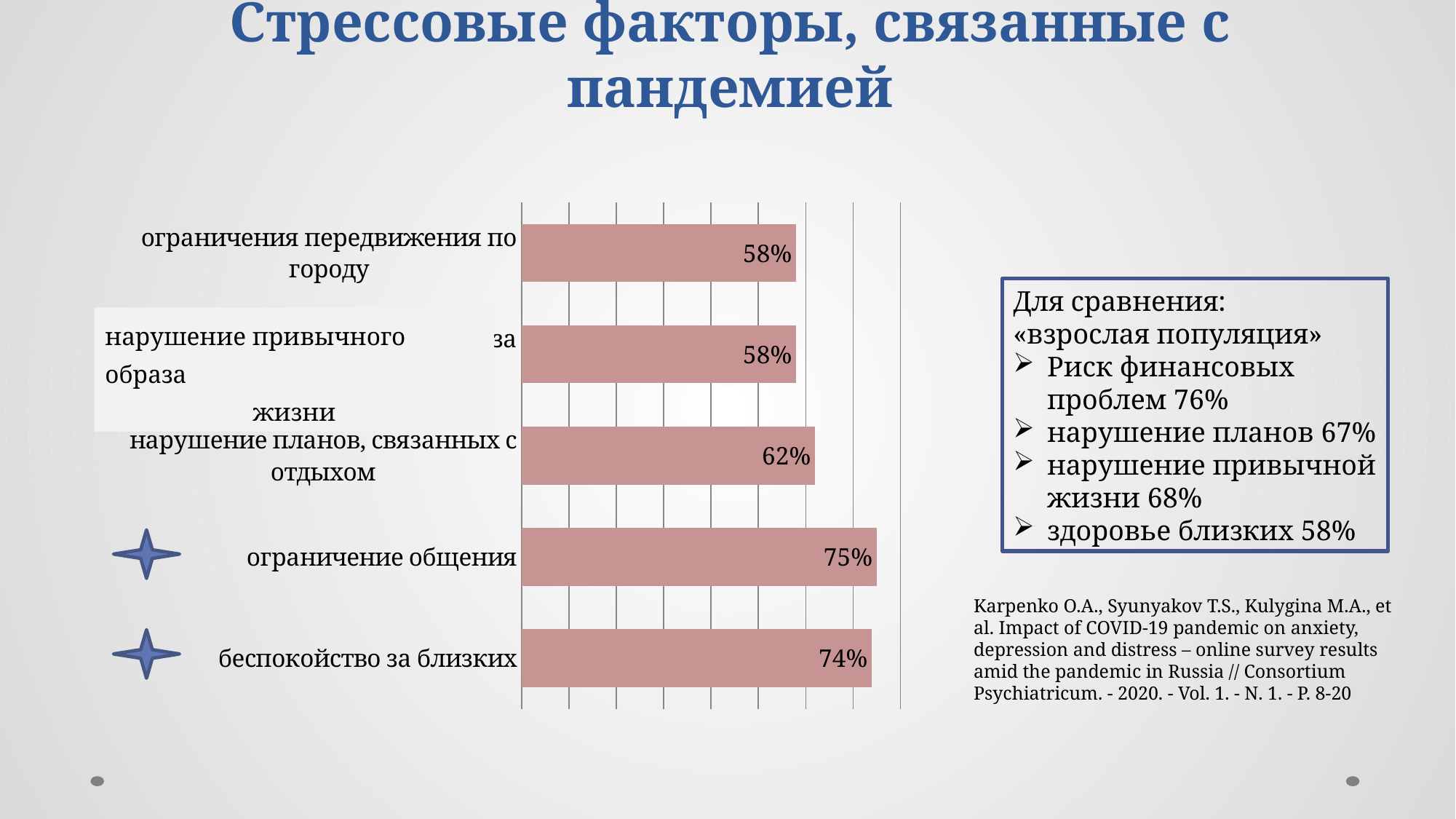
Which is larger: the value for «ограничение общения» or for «беспокойство за близких»? ограничение общения What is the difference between the values for «ограничение общения» and «беспокойство за близких»? 1% What is the title of the slide containing the chart? Стрессовые факторы, связанные с пандемией Which is larger: the value for «нарушение планов, связанных с отдыхом» or for «ограничения передвижения по городу»? нарушение планов, связанных с отдыхом Which category has the highest value in the chart? ограничение общения What is the difference between the values for «беспокойство за близких» and «нарушение планов, связанных с отдыхом»? 12% What type of chart is shown on the slide? bar chart What value is shown for «нарушение планов, связанных с отдыхом»? 62% How many categories are shown in the chart? 5 What value is shown for «ограничения передвижения по городу»? 58% What value is shown for «ограничение общения»? 75% What value is shown for «беспокойство за близких»? 74%